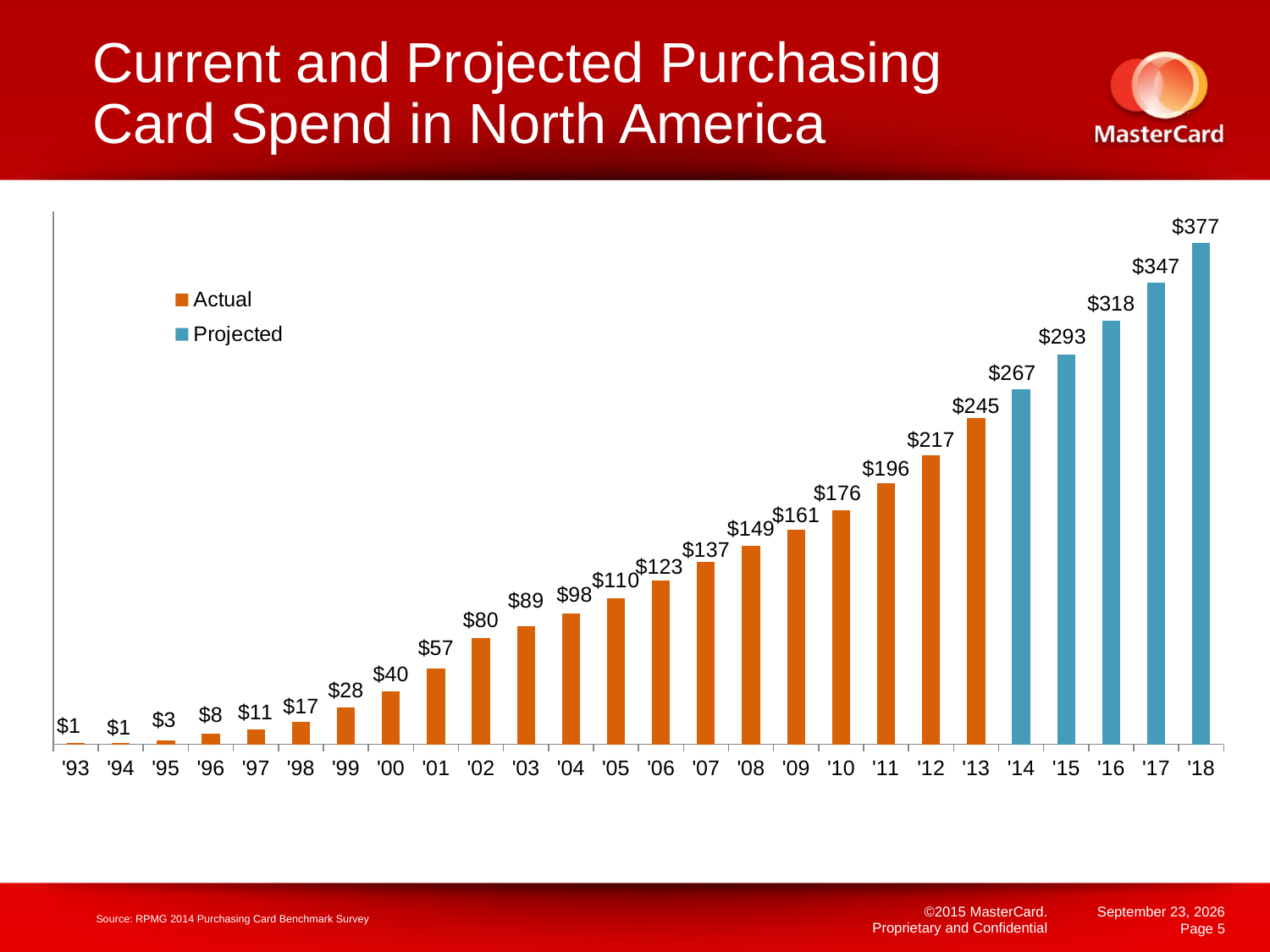
What is the difference between the values for '18 and '13? $132 What is the value for '05? $110 How many years are shown on the x axis? 26 What kind of chart is this? bar chart What is the value for '13? $245 Which is larger, the value for '07 or the value for '08? '08 What is the difference between the values for '10 and '09? $15 Which year has the highest value? '18 What is the projected value for '18? $377 How many series does the legend list? 2 Do the values rise or fall from '93 to '18? rise Which series is shown in blue? Projected